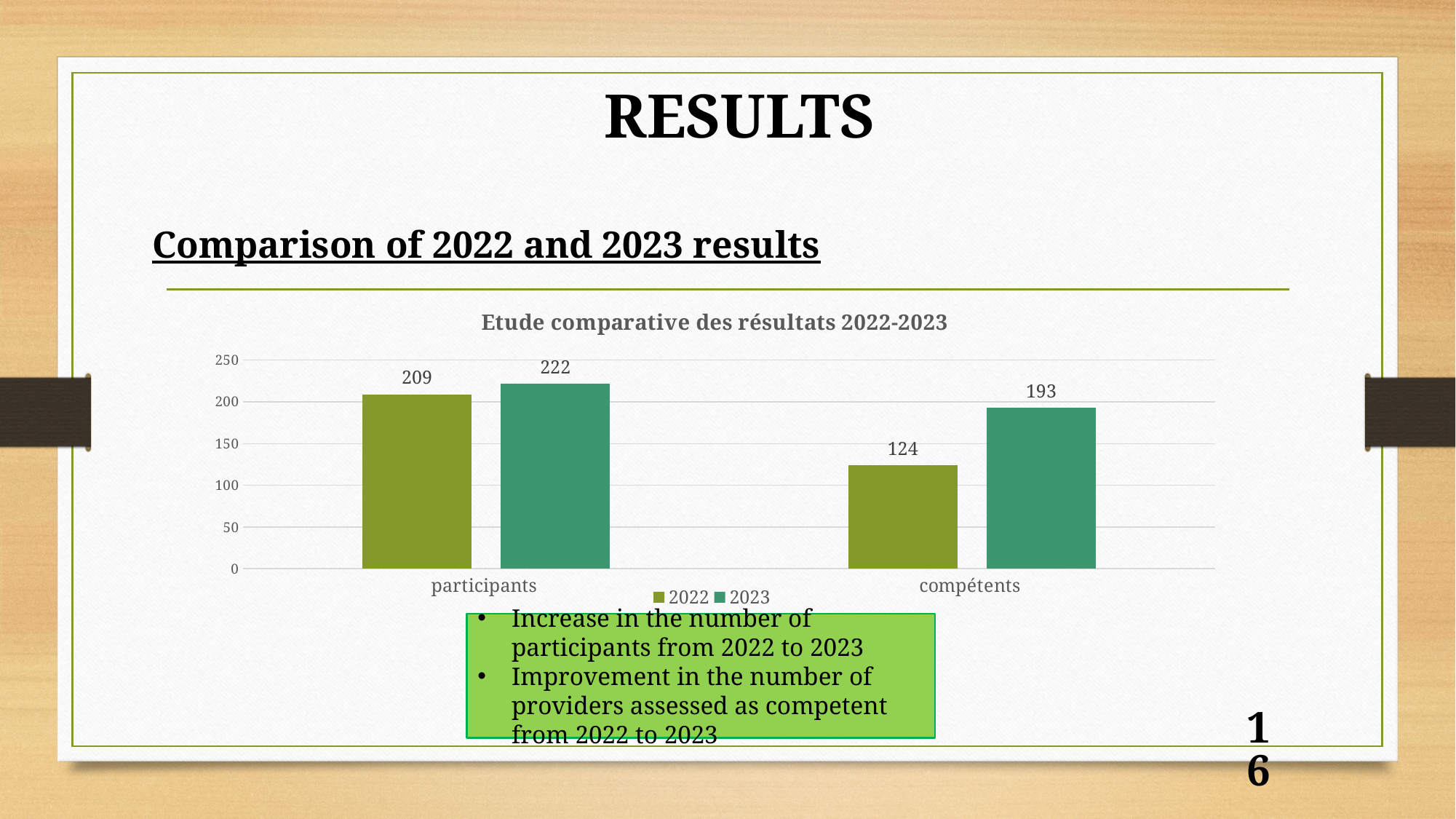
How many categories are shown on the x axis? 2 What is the value for compétents in 2023? 193 Which category has the highest value in the 2023 series? participants What is the value for participants in 2023? 222 What is the value for compétents in 2022? 124 What type of chart is shown on the slide? bar chart What is the difference between the 2023 and 2022 values for compétents? 69 What is the difference between the 2023 and 2022 values for participants? 13 How many series does the legend list? 2 Which is larger: the 2022 value for participants or the 2023 value for compétents? 2022 value for participants Which category has the lowest value in the 2022 series? compétents What is the value for participants in 2022? 209